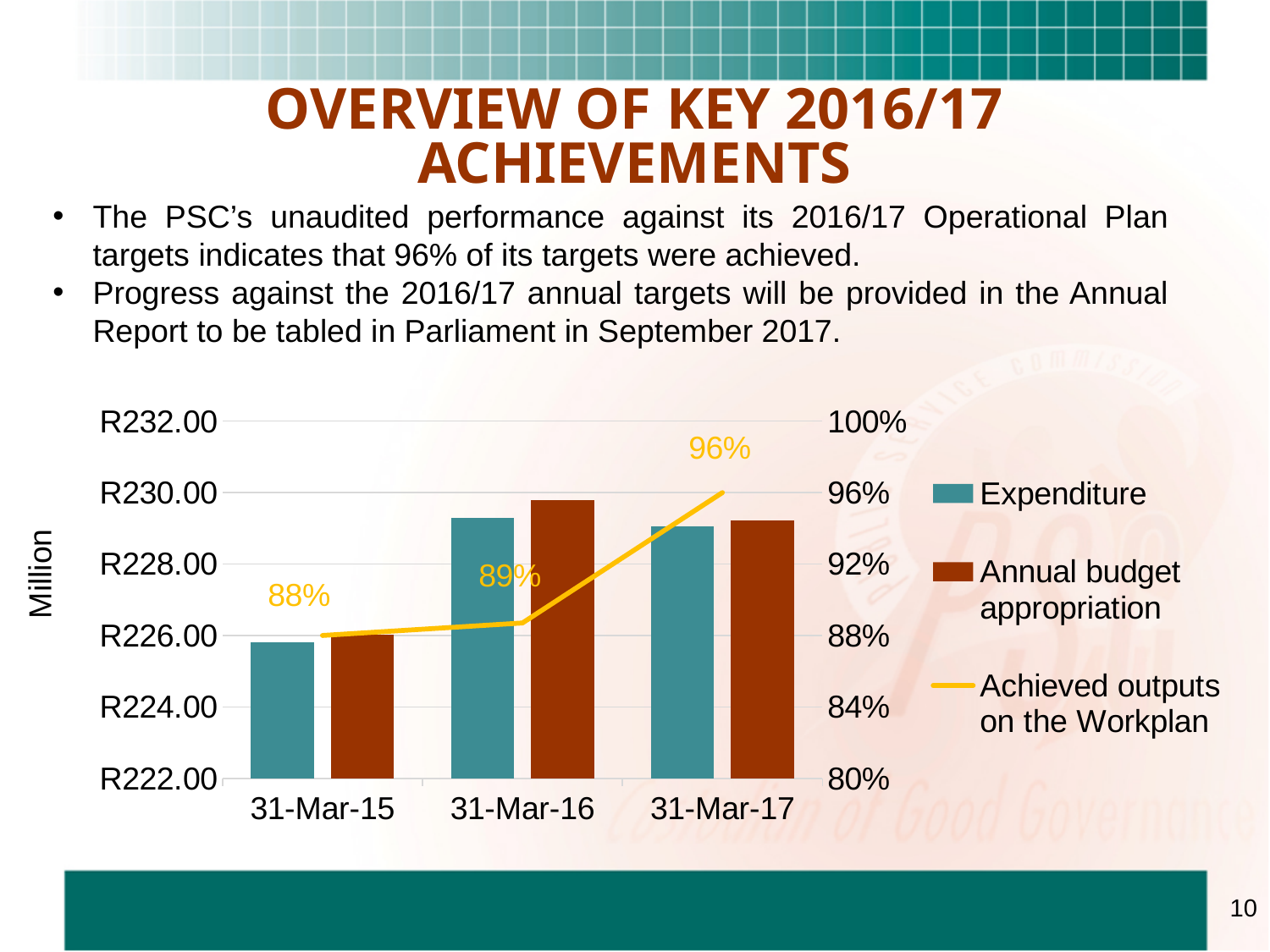
Does the Achieved outputs on the Workplan line rise or fall from 31-Mar-15 to 31-Mar-17? Rise How many series does the chart legend list? 3 Is the Annual budget appropriation value for 31-Mar-17 greater or less than R228.00? greater What is the Achieved outputs on the Workplan value for 31-Mar-15? 88% At which date is the Achieved outputs on the Workplan lowest? 31-Mar-15 How many dates are shown on the x axis of the chart? 3 Is the Expenditure value for 31-Mar-16 greater or less than R228.00? greater What is the Achieved outputs on the Workplan value for 31-Mar-17? 96% What is the Achieved outputs on the Workplan value for 31-Mar-16? 89% Which date has the larger Annual budget appropriation, 31-Mar-15 or 31-Mar-16? 31-Mar-16 At which date is the Achieved outputs on the Workplan highest? 31-Mar-17 By how many percentage points did Achieved outputs on the Workplan increase from 31-Mar-15 to 31-Mar-17? 8 percentage points